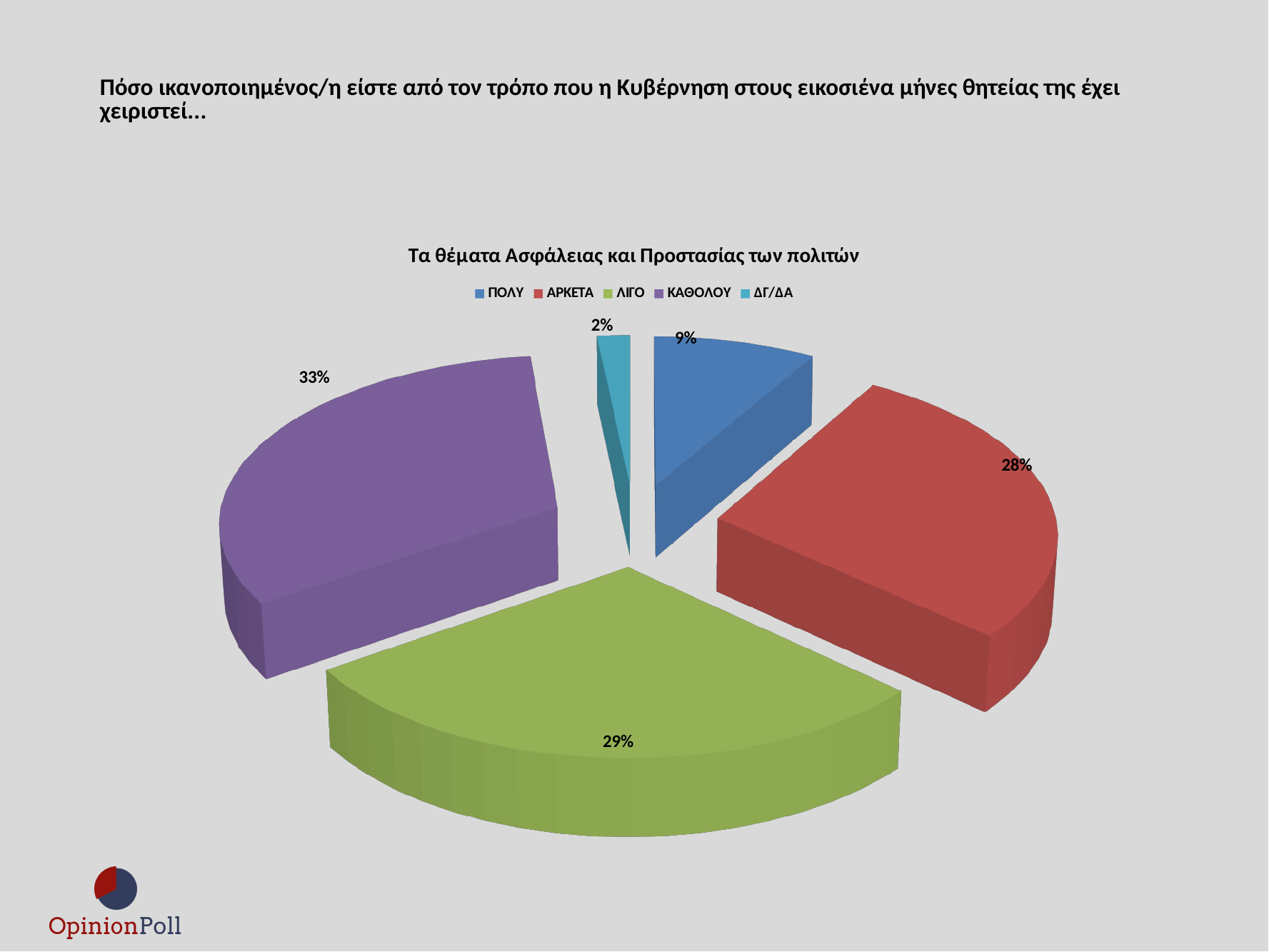
What is the difference in percentage points between ΚΑΘΟΛΟΥ and ΠΟΛΥ? 24 What type of chart is shown on the slide? pie chart Which category has the smallest share of the pie? ΔΓ/ΔΑ Which category has the largest share of the pie? ΚΑΘΟΛΟΥ What percentage is shown for ΚΑΘΟΛΟΥ? 33% What percentage is shown for ΛΙΓΟ? 29% What percentage is shown for ΔΓ/ΔΑ? 2% How many categories does the legend list? 5 What percentage is shown for ΑΡΚΕΤΑ? 28% What percentage is shown for ΠΟΛΥ? 9% Which is larger, the share for ΑΡΚΕΤΑ or the share for ΠΟΛΥ? ΑΡΚΕΤΑ What is the title of the chart? Τα θέματα Ασφάλειας και Προστασίας των πολιτών